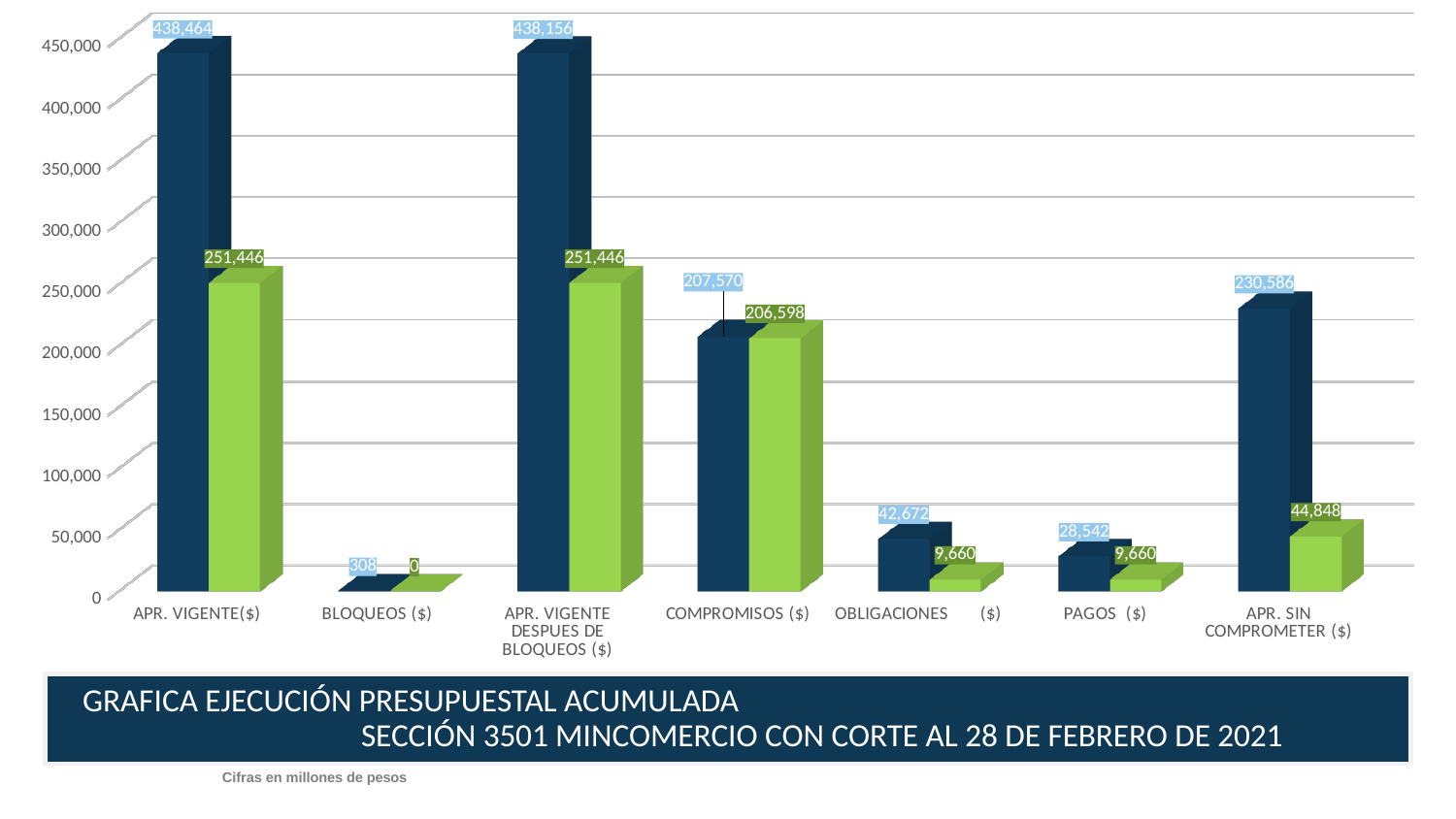
Which category has the highest dark blue bar? APR. VIGENTE($) What is the value of the dark blue bar for APR. VIGENTE($)? 438,464 What kind of chart is shown on the slide? Bar chart Which is larger, the dark blue bar for PAGOS ($) or the dark blue bar for OBLIGACIONES ($)? OBLIGACIONES ($) What is the value of the dark blue bar for BLOQUEOS ($)? 308 What is the title of the chart? GRAFICA EJECUCIÓN PRESUPUESTAL ACUMULADA SECCIÓN 3501 MINCOMERCIO CON CORTE AL 28 DE FEBRERO DE 2021 What is the value of the green bar for COMPROMISOS ($)? 206,598 What is the value of the dark blue bar for APR. SIN COMPROMETER ($)? 230,586 How many categories are shown on the x axis? 7 Which category has the lowest green bar? BLOQUEOS ($) What is the difference between the dark blue and green bars for OBLIGACIONES ($)? 33,012 What is the value of the green bar for APR. VIGENTE($)? 251,446